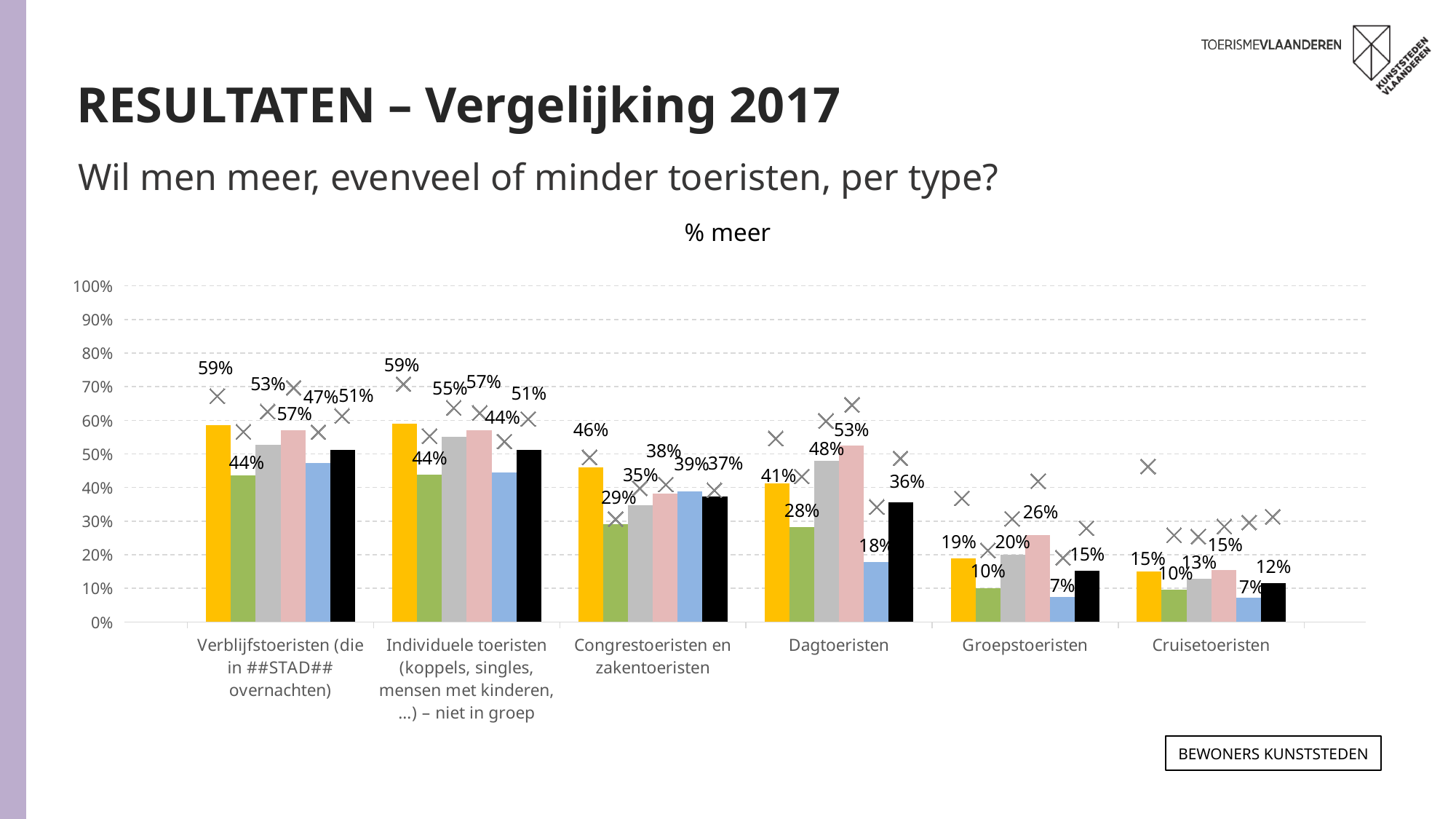
Which category has the highest value for the yellow bar? Verblijfstoeristen and Individuele toeristen (both 59%) Which category has the lowest value for the pink bar? Cruisetoeristen Is the value of the green bar for Groepstoeristen greater or less than 20%? less What kind of chart is shown on the slide? bar chart How many tourist-type categories are shown on the x axis? 6 What is the value of the blue bar for Dagtoeristen? 18% What is the title of the chart? % meer Which is larger for Congrestoeristen en zakentoeristen: the yellow bar or the green bar? the yellow bar (46%) What is the value of the black bar for Cruisetoeristen? 12% What is the value of the pink bar for Groepstoeristen? 26% What is the value of the yellow bar for Dagtoeristen? 41% What is the difference between the pink bar (53%) and the blue bar (18%) for Dagtoeristen? 35 percentage points